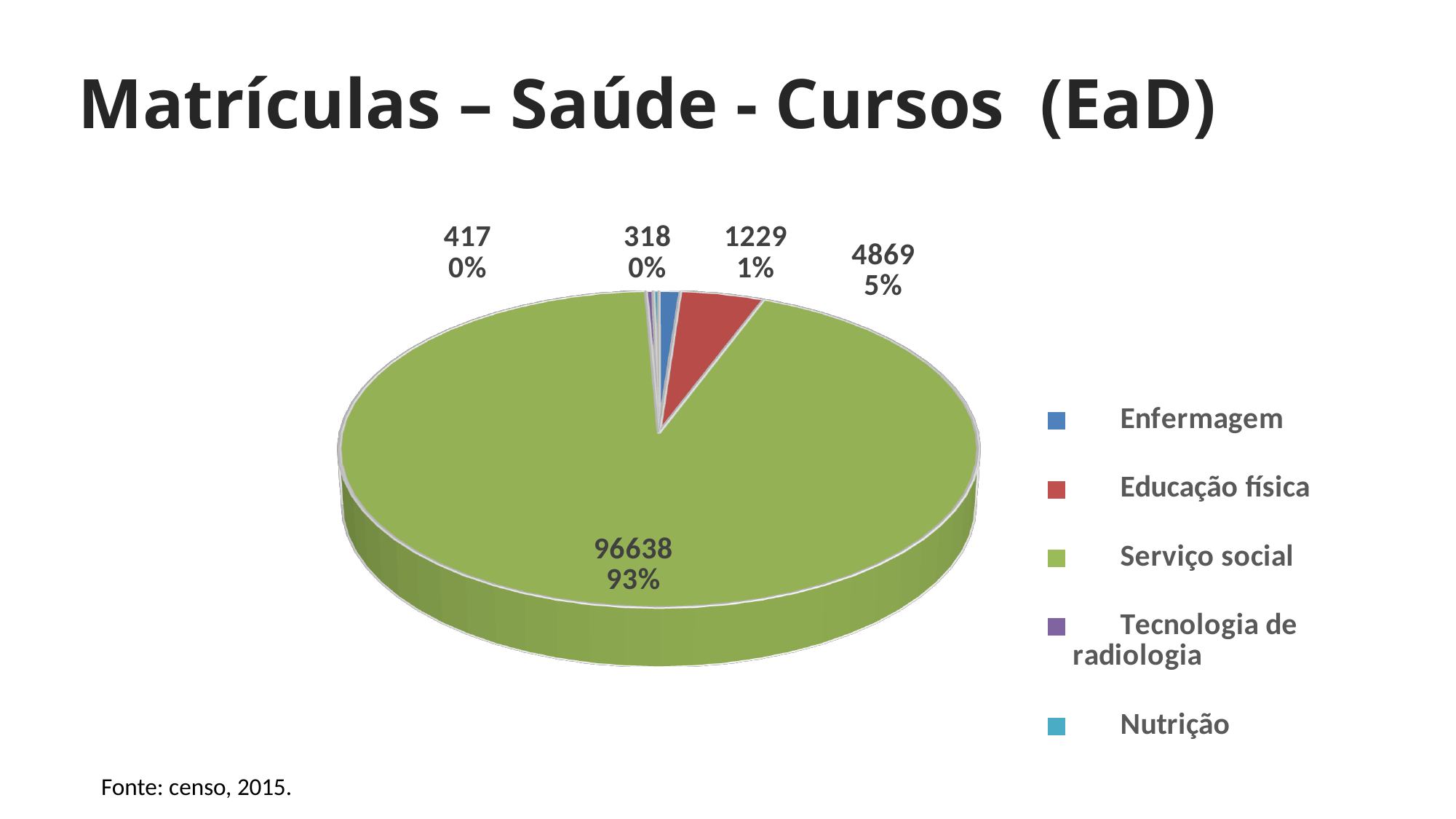
What is the title of the slide containing the chart? Matrículas – Saúde - Cursos (EaD) What share of the pie does Enfermagem represent? 1% What share of the pie does Serviço social represent? 93% What percentage of the pie is Educação física? 5% Which has more enrolments, Enfermagem or Educação física? Educação física What is the value shown for Enfermagem? 1229 What is the value shown for Educação física? 4869 What is the difference between the values for Educação física and Enfermagem? 3640 What kind of chart is shown on the slide? pie chart How many courses (categories) does the legend list? 5 How many enrolments (matrículas) are shown for Serviço social? 96638 Which course has the largest number of enrolments? Serviço social